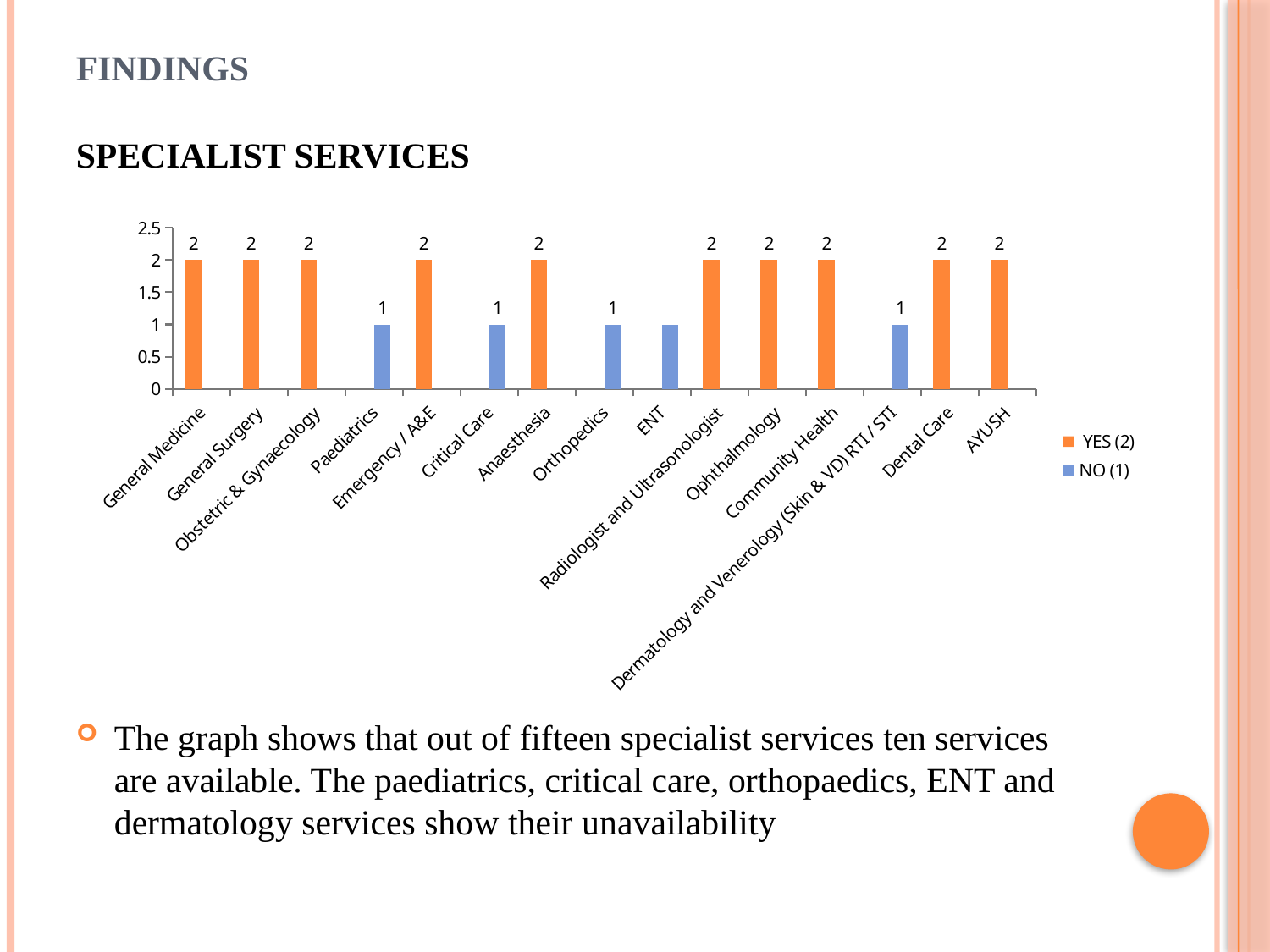
How many specialist service categories are shown on the x axis? 15 What kind of chart is shown on the slide? bar chart What is the value for Dental Care? 2 What is the value for Paediatrics? 1 What is the difference between the value for Anaesthesia and the value for Orthopedics? 1 Is the value for ENT greater or less than 1.5? less How many series does the legend list? 2 Which series does the blue colour represent in the legend? NO (1) Which series does the orange colour represent in the legend? YES (2) What is the value for Critical Care? 1 What is the value for General Medicine? 2 Which is larger, the value for Ophthalmology or the value for Dermatology and Venerology (Skin & VD) RTI / STI? Ophthalmology